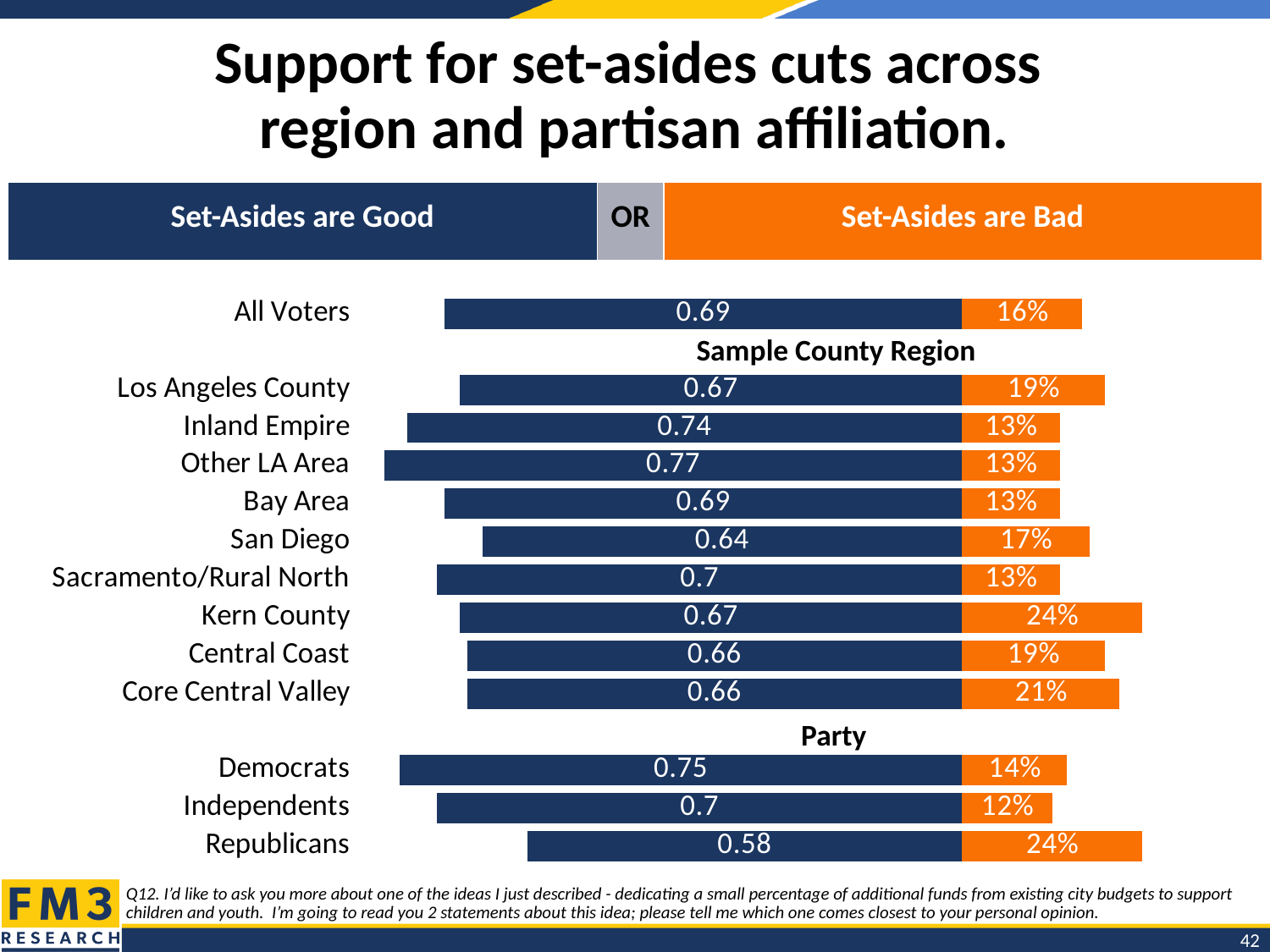
What is the 'Set-Asides are Bad' value for Independents? 12% How many series does the chart show? 2 What is the 'Set-Asides are Bad' value for Kern County? 24% What kind of chart is shown on the slide? Bar chart Which category has the lowest 'Set-Asides are Bad' value? Independents What is the difference between the 'Set-Asides are Good' values for Democrats and Republicans? 0.17 Which category has the lowest 'Set-Asides are Good' value? Republicans Which has a larger 'Set-Asides are Good' value, Inland Empire or San Diego? Inland Empire Which category has the highest 'Set-Asides are Good' value? Other LA Area How many categories are plotted in the chart? 13 What is the 'Set-Asides are Good' value for Republicans? 0.58 What is the 'Set-Asides are Good' value for All Voters? 0.69